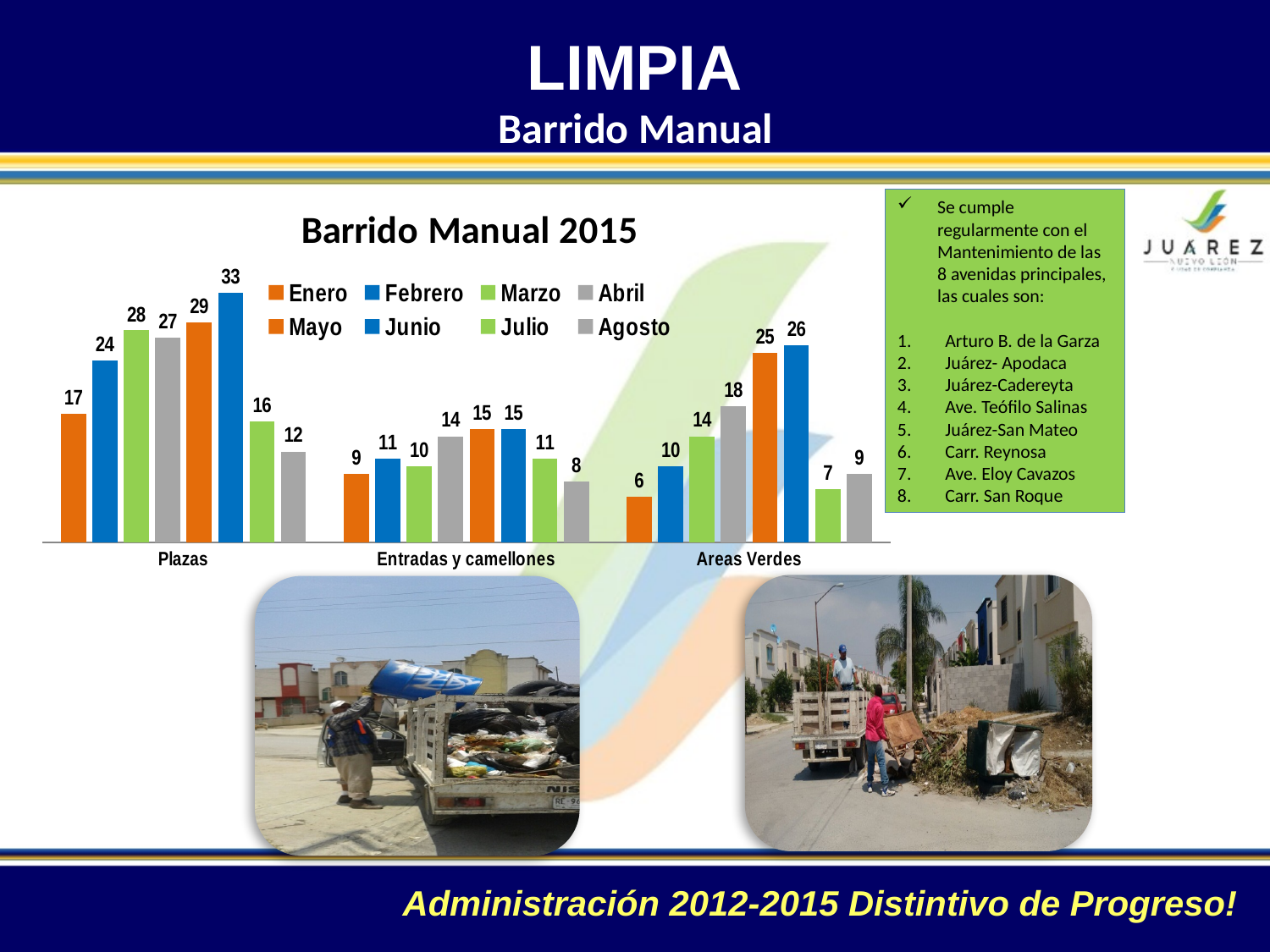
What is the value for Junio in the Plazas category? 33 What is the difference between the Junio value and the Enero value in the Plazas category? 16 What is the value for Enero in the Plazas category? 17 What is the value for Agosto in the Entradas y camellones category? 8 How many series does the chart legend list? 8 What type of chart is shown on the slide? bar chart What is the lowest value shown in the Areas Verdes category? 6 What is the highest value shown in the Plazas category? 33 How many categories are shown on the x axis of the chart? 3 What is the title of the chart? Barrido Manual 2015 What is the value for Abril in the Areas Verdes category? 18 Which is larger in the Entradas y camellones category, the Mayo value or the Agosto value? Mayo